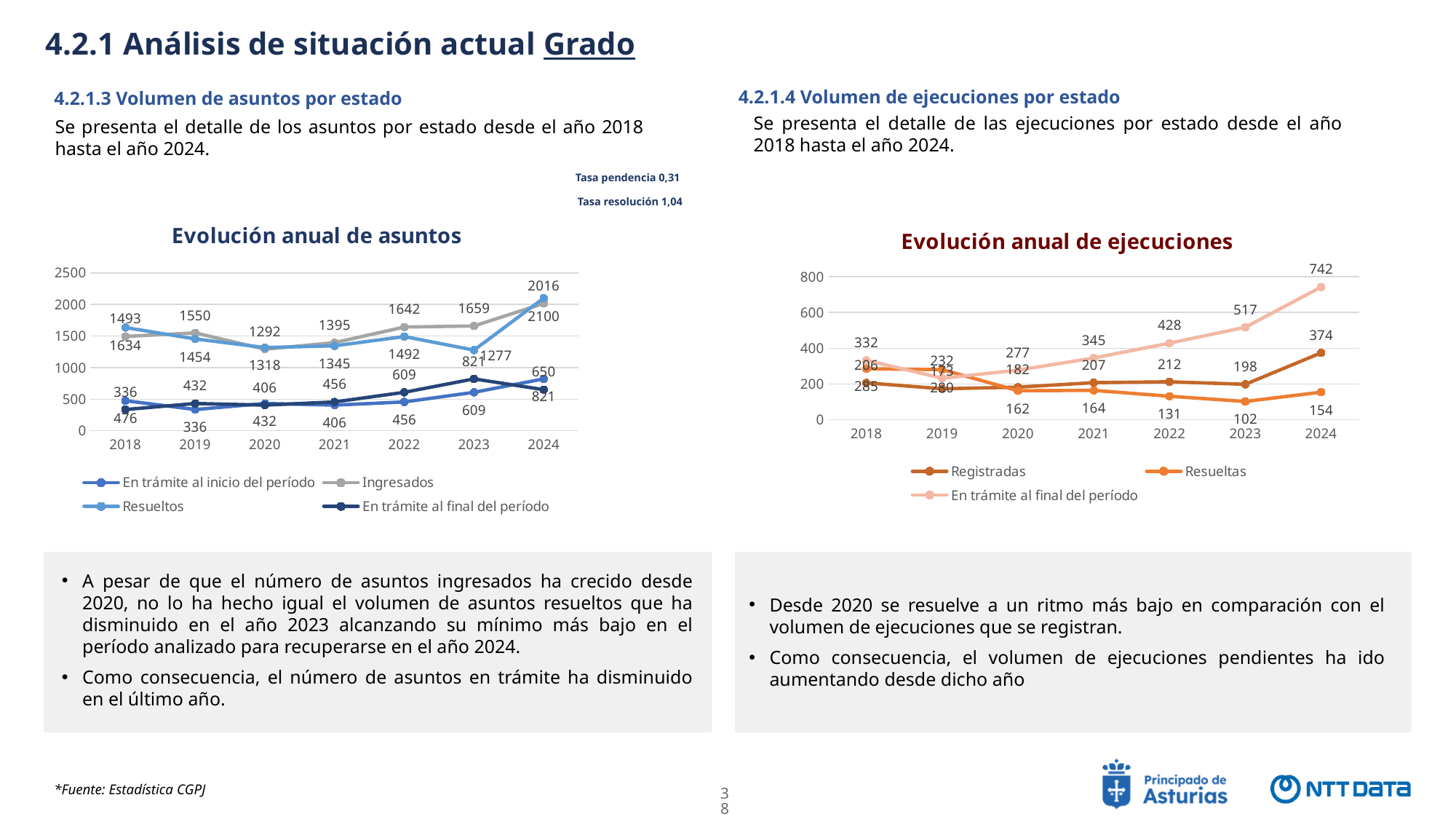
In the chart 'Evolución anual de ejecuciones', what is the value of 'En trámite al final del período' in 2024? 742 In the chart 'Evolución anual de asuntos', what is the value of 'En trámite al final del período' in 2024? 650 What kind of chart is 'Evolución anual de asuntos'? line chart In the chart 'Evolución anual de asuntos', which is larger in 2023, 'Ingresados' or 'Resueltos'? Ingresados In the chart 'Evolución anual de ejecuciones', what is the difference between 'En trámite al final del período' and 'Registradas' in 2024? 368 How many years are shown on the x axis of the chart 'Evolución anual de asuntos'? 7 In the chart 'Evolución anual de ejecuciones', does 'En trámite al final del período' rise or fall from 2020 to 2024? rises In the chart 'Evolución anual de ejecuciones', what is the value of 'Registradas' in 2024? 374 How many series does the legend of the chart 'Evolución anual de ejecuciones' list? 3 In the chart 'Evolución anual de ejecuciones', in which year is 'Resueltas' lowest? 2023 In the chart 'Evolución anual de asuntos', what is the value of 'Resueltos' in 2023? 1277 How many series does the legend of the chart 'Evolución anual de asuntos' list? 4